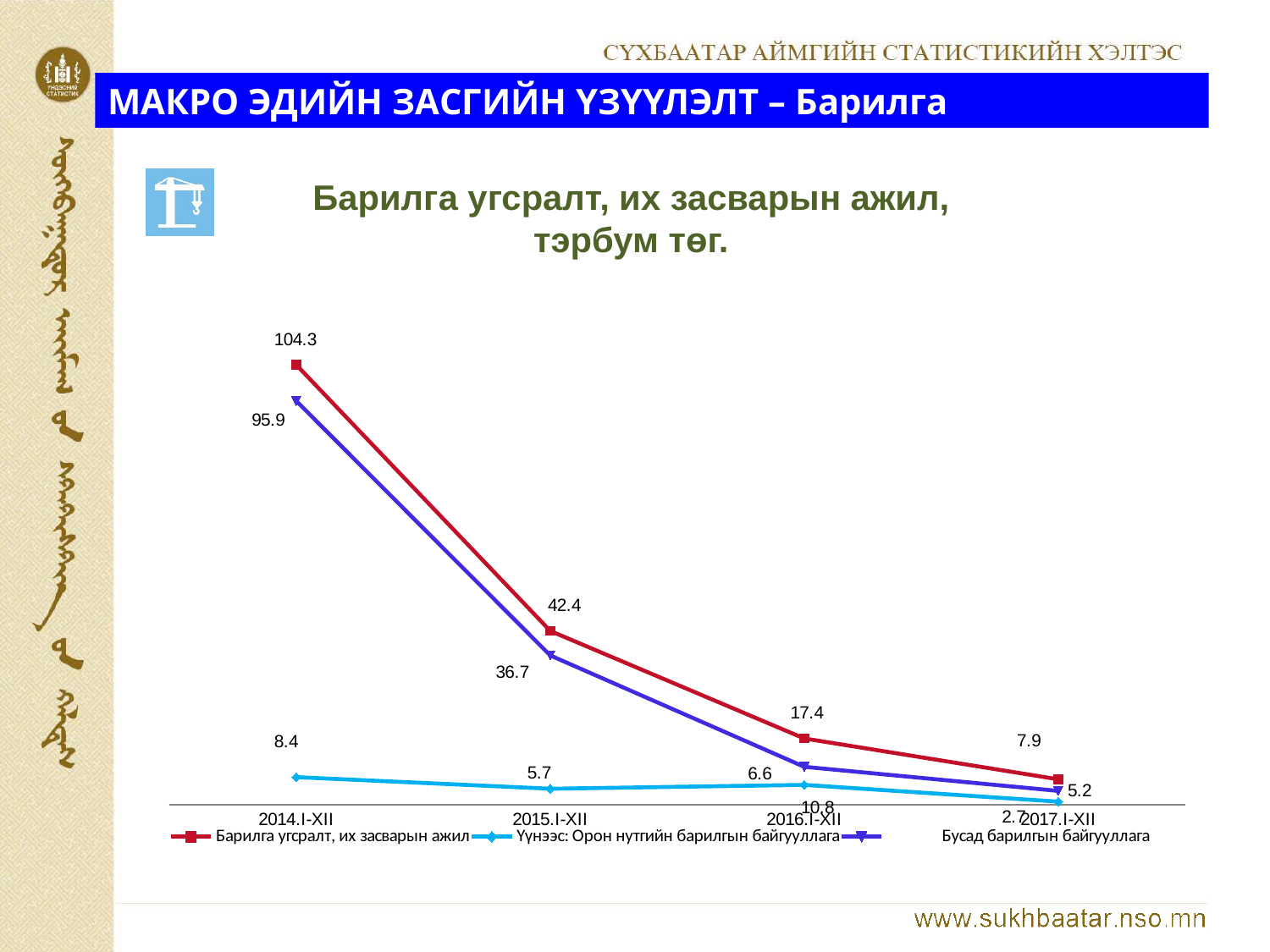
How many periods are shown on the x axis? 4 What is the difference between Барилга угсралт, их засварын ажил and Бусад барилгын байгууллага in 2014.I-XII? 8.4 Which is larger in 2016.I-XII: Барилга угсралт, их засварын ажил or Үүнээс: Орон нутгийн барилгын байгууллага? Барилга угсралт, их засварын ажил What is the value of Бусад барилгын байгууллага in 2015.I-XII? 36.7 In which period is Барилга угсралт, их засварын ажил highest? 2014.I-XII In which period is Бусад барилгын байгууллага lowest? 2017.I-XII Does Барилга угсралт, их засварын ажил rise or fall from 2014.I-XII to 2017.I-XII? fall What is the value of Барилга угсралт, их засварын ажил in 2017.I-XII? 7.9 What is the value of Үүнээс: Орон нутгийн барилгын байгууллага in 2014.I-XII? 8.4 What type of chart is shown on the slide? line chart How many series does the legend list? 3 What is the value of Барилга угсралт, их засварын ажил in 2014.I-XII? 104.3